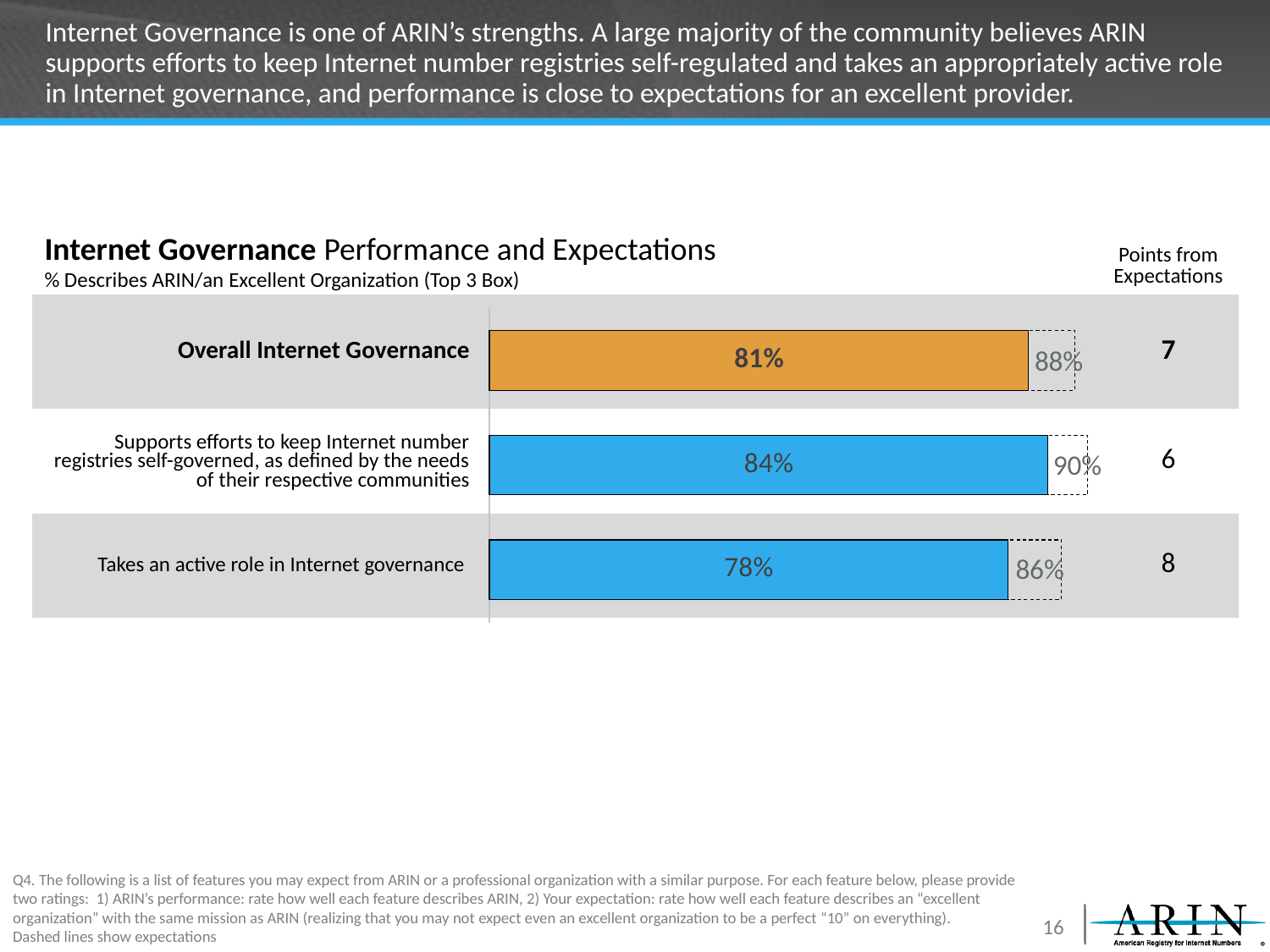
What is the performance value for Supports efforts to keep Internet number registries self-governed, as defined by the needs of their respective communities? 84% What is the 'Points from Expectations' value shown for Supports efforts to keep Internet number registries self-governed? 6 What is the performance value for Overall Internet Governance? 81% What is the difference between the expectation and performance values for Takes an active role in Internet governance? 8 How many categories are shown in the chart? 3 What is the expectation value (dashed bar) for Overall Internet Governance? 88% Which category has the highest performance value? Supports efforts to keep Internet number registries self-governed, as defined by the needs of their respective communities What kind of chart is shown on the slide? Bar chart Which is larger: the performance value for Overall Internet Governance or for Takes an active role in Internet governance? Overall Internet Governance Which category has the lowest performance value? Takes an active role in Internet governance What is the expectation value (dashed bar) for Takes an active role in Internet governance? 86% What is the difference in performance between Supports efforts to keep Internet number registries self-governed and Takes an active role in Internet governance? 6%